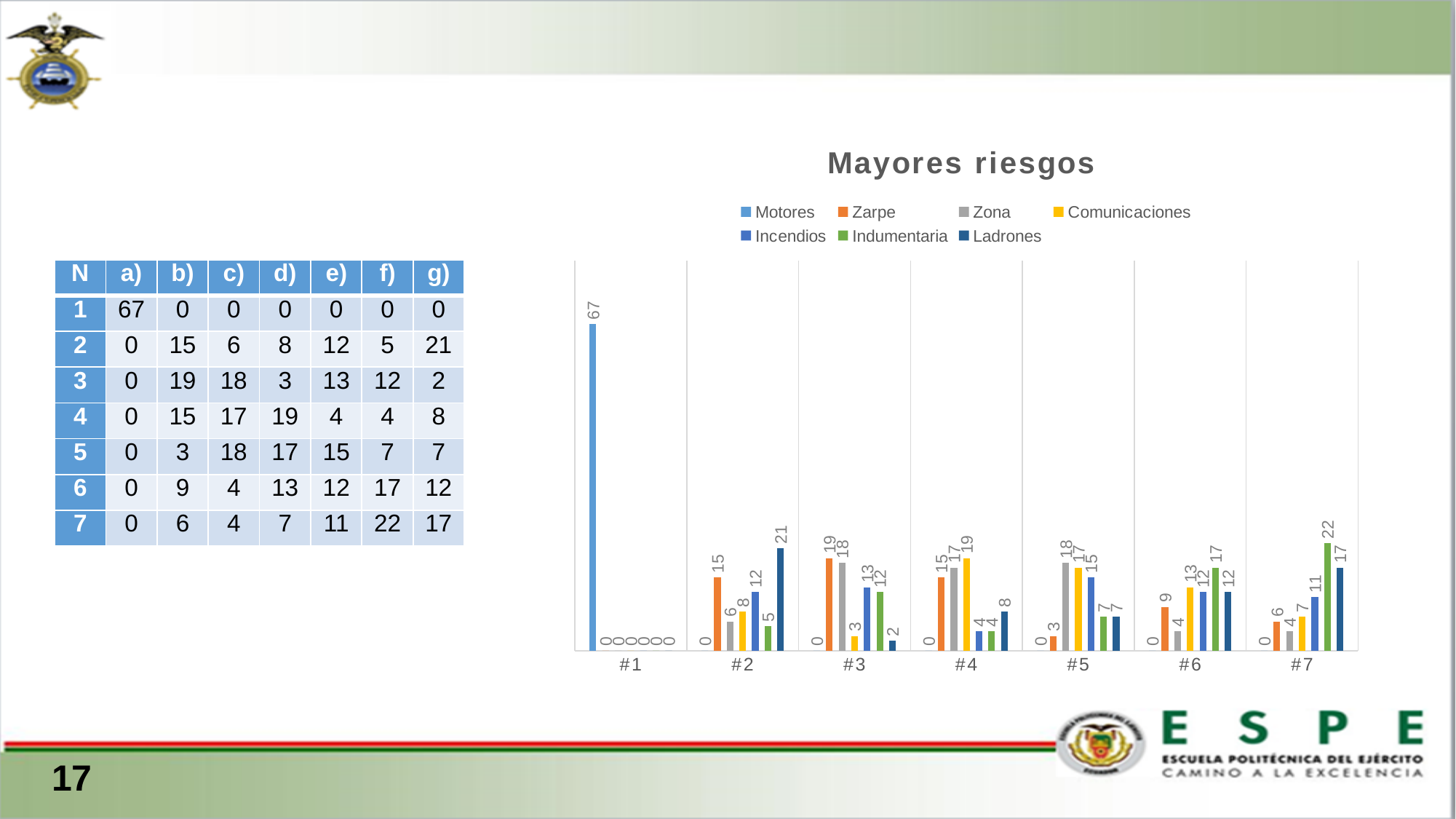
How many series does the legend of the "Mayores riesgos" chart list? 7 What is the value of Incendios for category #5 in the "Mayores riesgos" chart? 15 Which series has the highest value in category #4 of the "Mayores riesgos" chart? Comunicaciones In category #6 of the "Mayores riesgos" chart, which is larger: Indumentaria or Zarpe? Indumentaria What is the value of Indumentaria for category #7 in the "Mayores riesgos" chart? 22 What is the difference between the Zarpe and Zona values for category #2 in the "Mayores riesgos" chart? 9 Which series is shown in orange in the "Mayores riesgos" chart? Zarpe What is the value of Motores for category #1 in the "Mayores riesgos" chart? 67 How many categories are shown on the x axis of the "Mayores riesgos" chart? 7 Which series has the lowest value in category #3 of the "Mayores riesgos" chart? Motores What is the value of Ladrones for category #2 in the "Mayores riesgos" chart? 21 What type of chart is shown under the title "Mayores riesgos"? bar chart